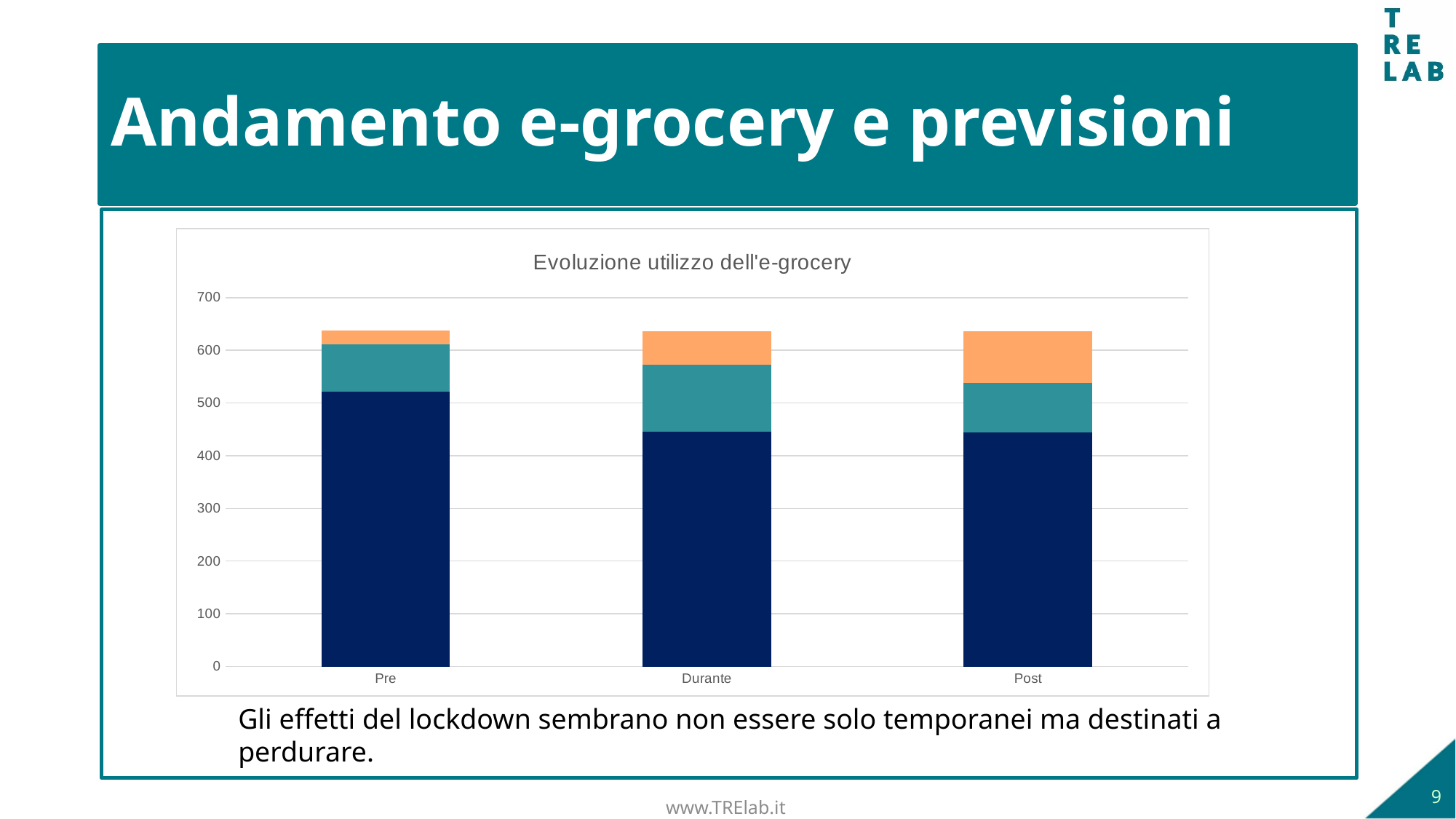
Which category has the largest orange (top) segment? Post Is the orange (top) segment larger for Pre or for Post? Post How many categories are shown on the x axis of the chart? 3 Which category has the largest dark blue (bottom) segment? Pre Is the dark blue (bottom) segment of the Post bar greater or less than 500? less Is the total height of the Pre bar greater or less than 600? greater Is the dark blue (bottom) segment of the Durante bar greater or less than 500? less What are the category labels on the x axis, from left to right? Pre, Durante, Post What is the title of the chart? Evoluzione utilizzo dell'e-grocery What kind of chart is shown on the slide? stacked bar chart